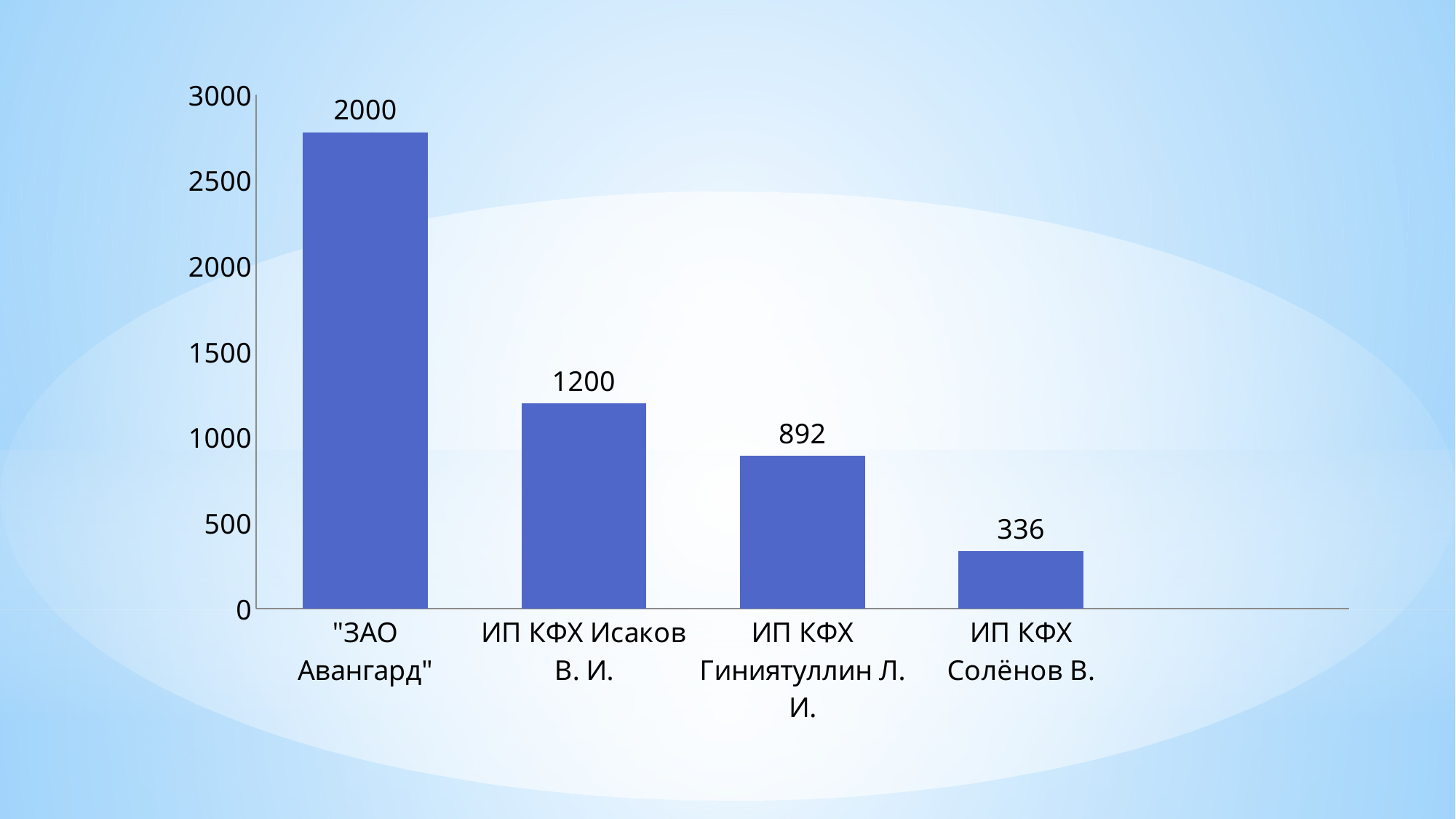
Which category has the lowest value? ИП КФХ Солёнов В. How many categories are shown on the chart? 4 What is the value for ИП КФХ Гиниятуллин Л. И.? 892 What kind of chart is shown on the slide? bar chart What is the difference between the values for ИП КФХ Гиниятуллин Л. И. and ИП КФХ Солёнов В.? 556 Is the value for ИП КФХ Солёнов В. greater or less than 500? less Which is larger, the value for ИП КФХ Исаков В. И. or the value for ИП КФХ Солёнов В.? ИП КФХ Исаков В. И. What is the difference between the values for ИП КФХ Исаков В. И. and ИП КФХ Гиниятуллин Л. И.? 308 What is the value for ИП КФХ Солёнов В.? 336 Which category has the highest value? "ЗАО Авангард" What is the value for ИП КФХ Исаков В. И.? 1200